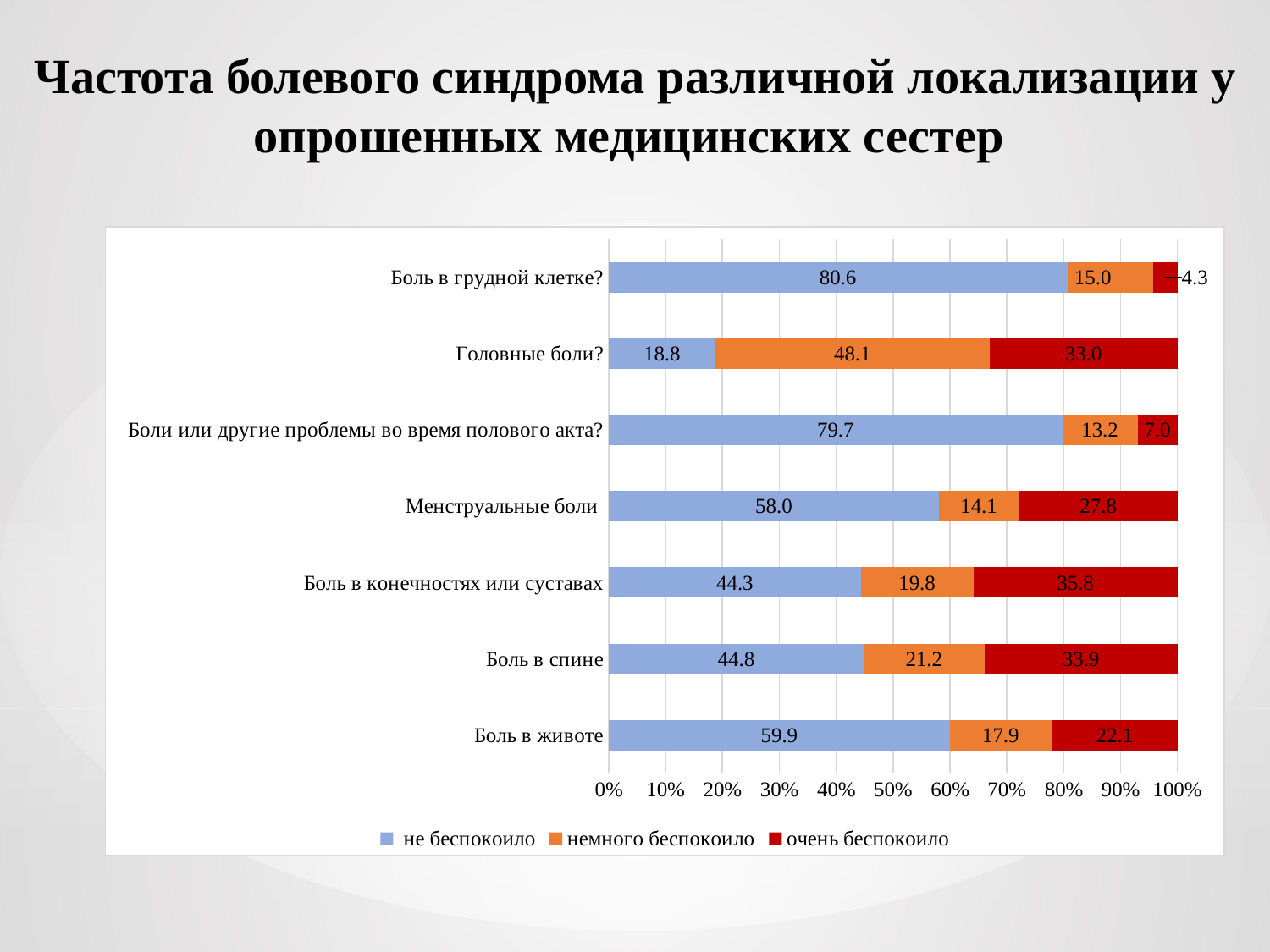
Which category has the lowest value for "не беспокоило"? Головные боли? What is the value of "очень беспокоило" for "Боль в конечностях или суставах"? 35.8 Which is larger: the "очень беспокоило" value for "Менструальные боли" or for "Боль в животе"? Менструальные боли What is the value of "очень беспокоило" for "Боль в грудной клетке?"? 4.3 Which category has the highest value for "не беспокоило"? Боль в грудной клетке? How many categories are shown on the chart? 7 What is the value of "немного беспокоило" for "Боль в спине"? 21.2 What kind of chart is shown on the slide? Stacked bar chart How many series does the legend list? 3 What is the value of "не беспокоило" for "Головные боли?"? 18.8 What is the difference between the "не беспокоило" values for "Боль в грудной клетке?" and "Головные боли?"? 61.8 Which category has the highest value for "немного беспокоило"? Головные боли?